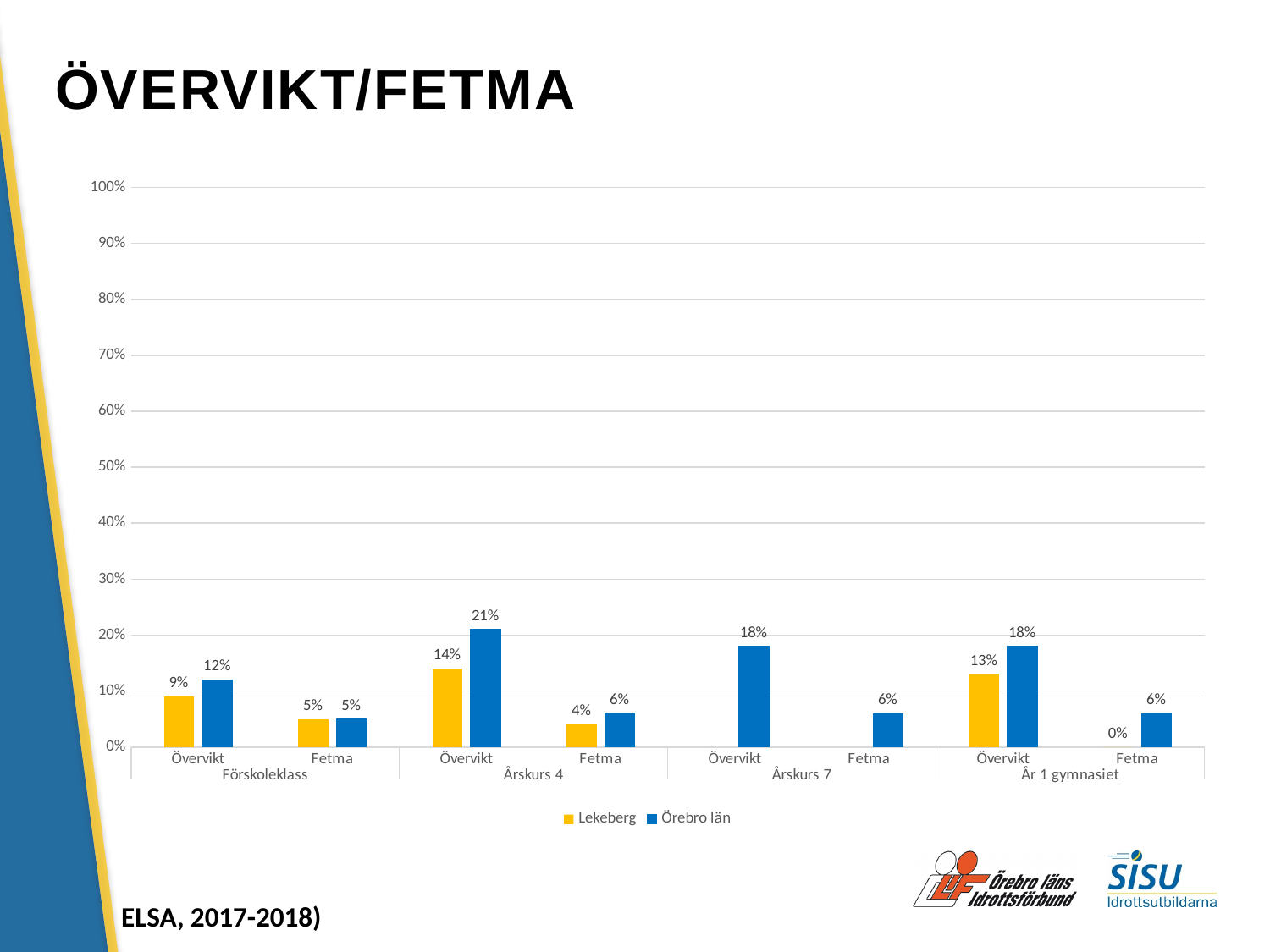
What is the Örebro län value for Övervikt in Årskurs 7? 18% Which is larger for Fetma in Årskurs 4: the Lekeberg value or the Örebro län value? Örebro län What is the difference between the Örebro län and Lekeberg values for Övervikt in År 1 gymnasiet? 5% What kind of chart is shown on the slide? Bar chart Which category has the highest Örebro län value? Övervikt, Årskurs 4 Is the Örebro län value for Övervikt in Årskurs 4 greater or less than 20%? greater What is the difference between the Örebro län and Lekeberg values for Övervikt in Årskurs 4? 7% Which colour represents Lekeberg in the chart? Yellow What is the Lekeberg value for Övervikt in Förskoleklass? 9% How many series does the legend list? 2 What is the Lekeberg value for Fetma in År 1 gymnasiet? 0% What is the Örebro län value for Övervikt in Årskurs 4? 21%